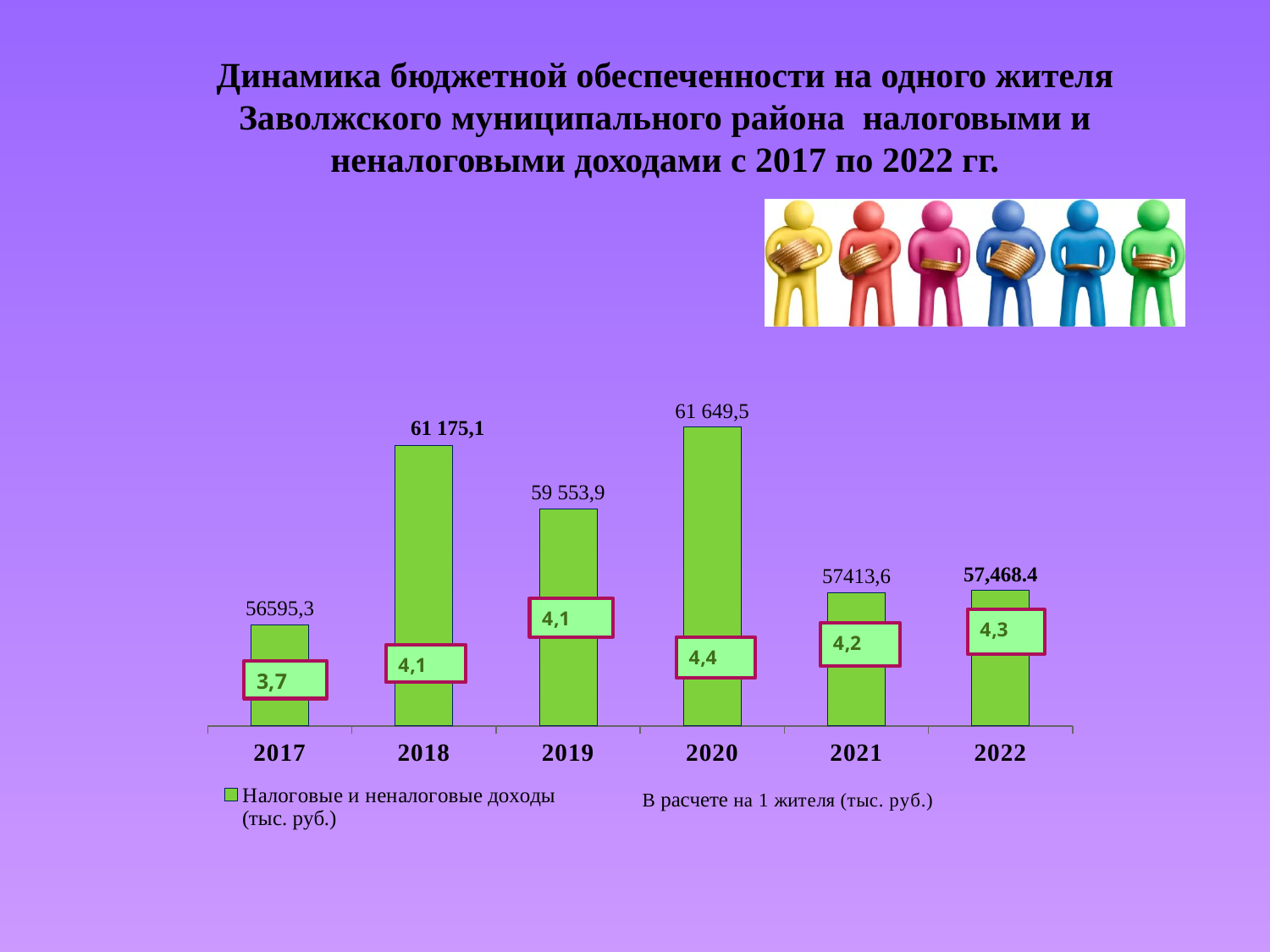
What is the value of tax and non-tax revenue (тыс. руб.) for 2017? 56595,3 Which year has the highest tax and non-tax revenue? 2020 What is the per-resident value (В расчете на 1 жителя) shown for 2017? 3,7 Which year has the lowest tax and non-tax revenue? 2017 Which year has the larger tax and non-tax revenue, 2019 or 2021? 2019 How many years are shown on the x axis of the chart? 6 What is the difference between the per-resident values for 2020 and 2017? 0,7 What is the per-resident value (В расчете на 1 жителя) shown for 2020? 4,4 What is the difference between the tax and non-tax revenue for 2020 and 2018? 474,4 What is the value of tax and non-tax revenue (тыс. руб.) for 2022? 57,468.4 What is the value of tax and non-tax revenue (тыс. руб.) for 2020? 61 649,5 What kind of chart is shown on the slide? Bar chart